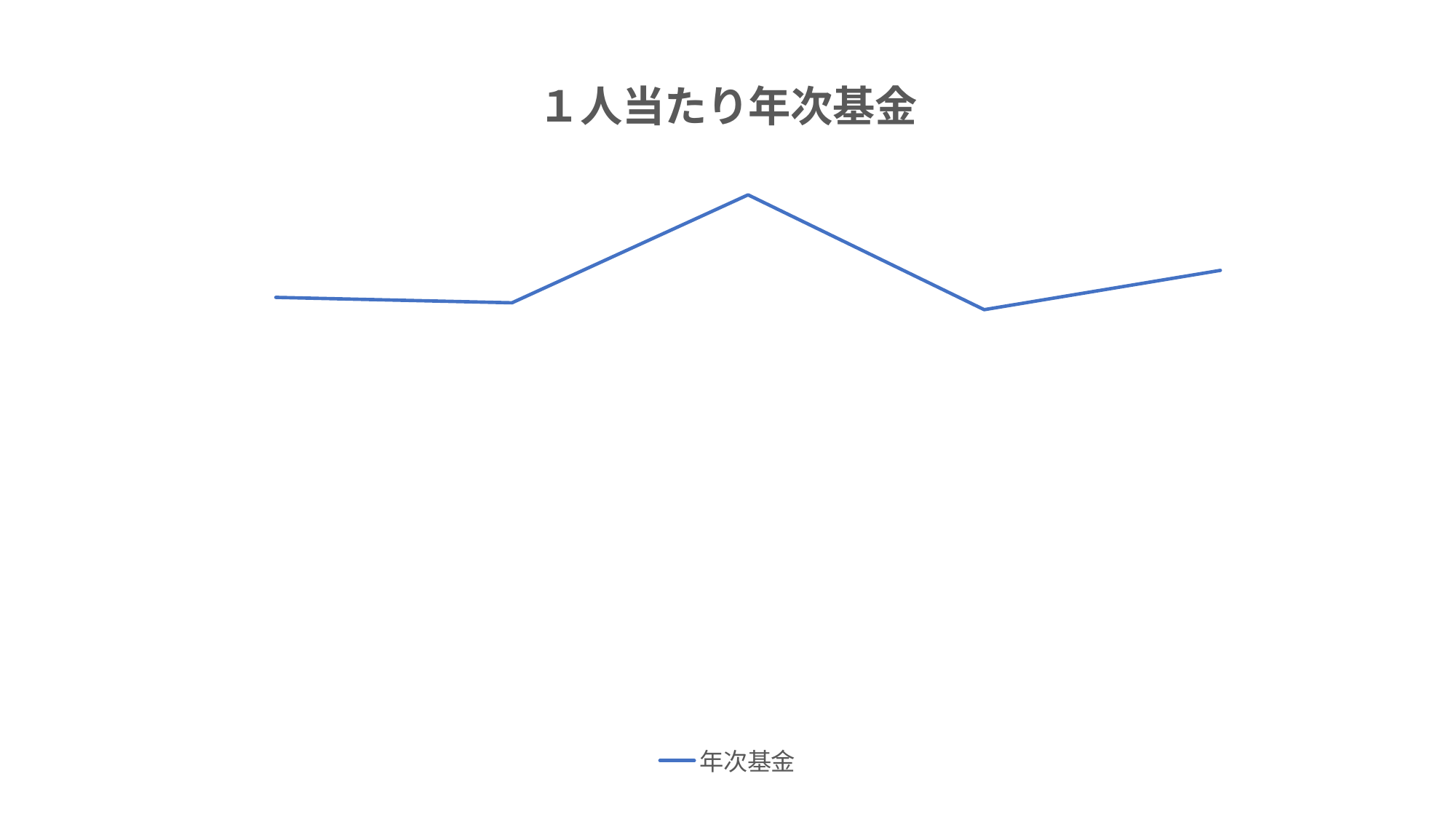
Does the line rise or fall between the third and fourth points from the left? falls How many data points are plotted on the line? 5 Which is higher on the line: the first point or the third point from the left? the third point Does the line rise or fall between the second and third points from the left? rises Which data point, counting from the left, is the highest on the line? the third point Does the line rise or fall between the fourth and fifth points from the left? rises How many series does the legend list? 1 What is the title of the chart? １人当たり年次基金 What kind of chart is shown on the slide? line chart Which is higher on the line: the third point or the fifth point from the left? the third point What is the name of the series shown in the legend? 年次基金